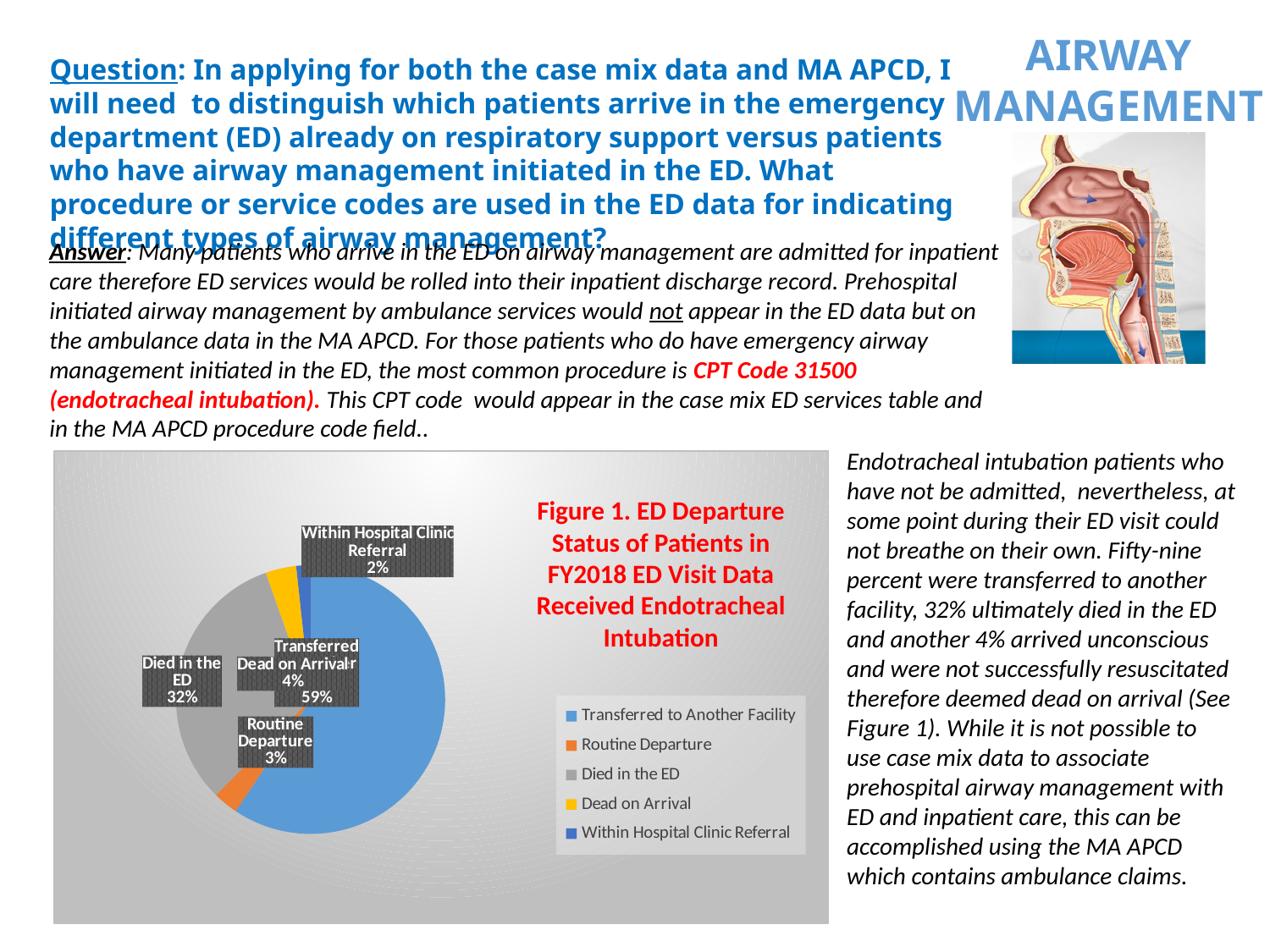
What is the title of the pie chart on the slide? Figure 1. ED Departure Status of Patients in FY2018 ED Visit Data Received Endotracheal Intubation What percentage of patients in Figure 1 had a routine departure? 3% In Figure 1, what is the difference in percentage points between patients transferred to another facility and patients who died in the ED? 27 What percentage of patients in Figure 1 had a within hospital clinic referral? 2% In Figure 1, which is larger: the share for Dead on Arrival or the share for Routine Departure? Dead on Arrival What type of chart is shown in Figure 1? pie chart What percentage of patients in Figure 1 were dead on arrival? 4% What percentage of patients in Figure 1 died in the ED? 32% Which departure status has the largest share in Figure 1? Transferred to Another Facility What percentage of patients in Figure 1 were transferred to another facility? 59% Which departure status has the smallest share in Figure 1? Within Hospital Clinic Referral How many departure status categories does the legend of Figure 1 list? 5